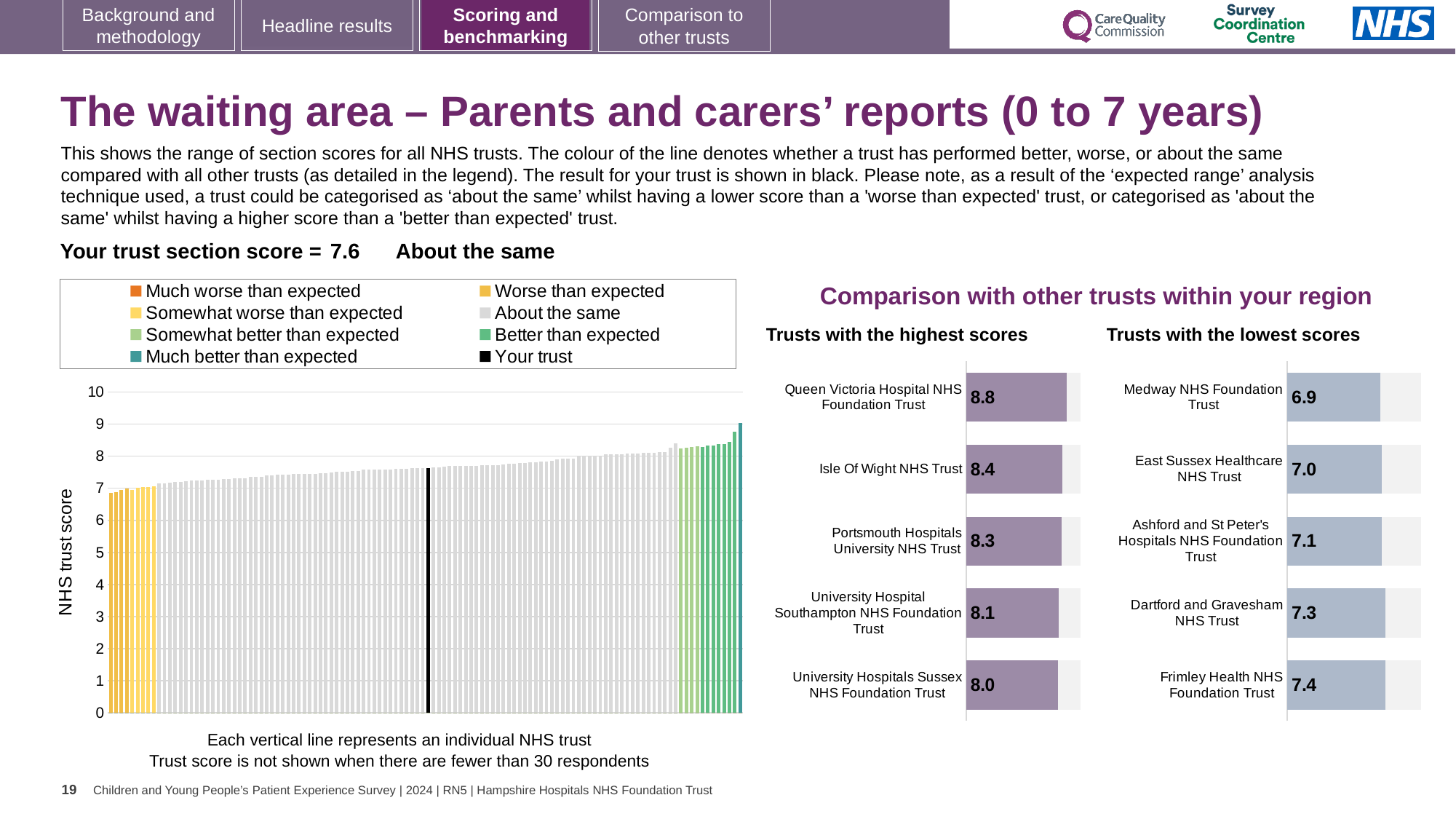
In the 'Trusts with the lowest scores' chart, what is the score for Frimley Health NHS Foundation Trust? 7.4 How many trusts are shown in the 'Trusts with the highest scores' chart? 5 In the left-hand chart, is the value of the black bar for your trust greater or less than 7? greater What kind of chart is the large chart on the left showing NHS trust scores? Bar chart In the 'Trusts with the lowest scores' chart, what is the score for Medway NHS Foundation Trust? 6.9 In the 'Trusts with the highest scores' chart, what is the difference between the scores of Queen Victoria Hospital NHS Foundation Trust and University Hospitals Sussex NHS Foundation Trust? 0.8 In the 'Trusts with the lowest scores' chart, which trust has the lowest score? Medway NHS Foundation Trust In the 'Trusts with the highest scores' chart, which trust has the highest score? Queen Victoria Hospital NHS Foundation Trust In the 'Trusts with the highest scores' chart, which has the higher score: Isle Of Wight NHS Trust or Portsmouth Hospitals University NHS Trust? Isle Of Wight NHS Trust In the 'Trusts with the lowest scores' chart, what is the difference between the scores of Frimley Health NHS Foundation Trust and Medway NHS Foundation Trust? 0.5 In the 'Trusts with the highest scores' chart, what is the score for Queen Victoria Hospital NHS Foundation Trust? 8.8 How many entries does the legend above the left-hand chart list? 8